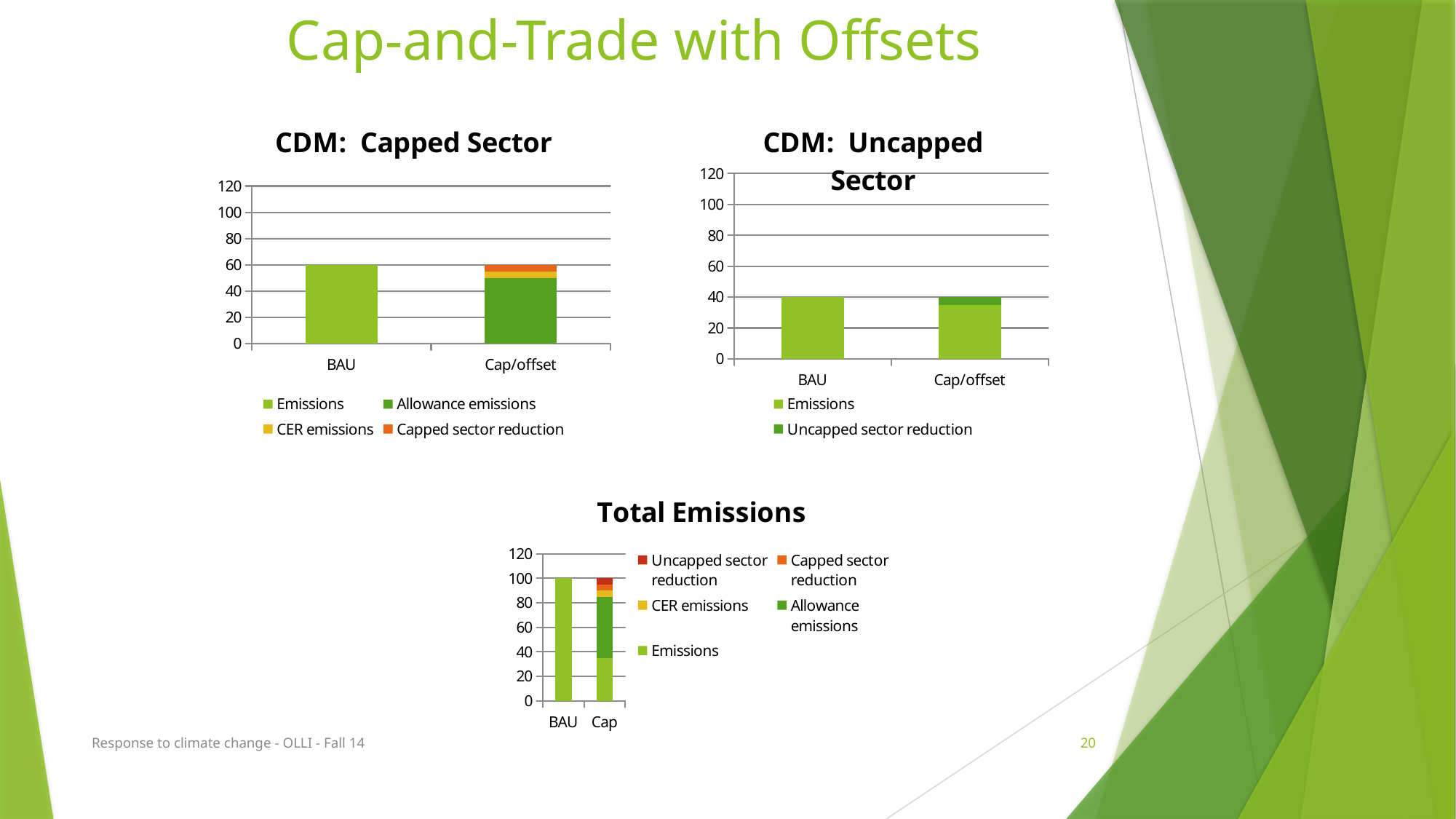
In the Total Emissions chart, is the Emissions value for Cap greater or less than 40? less In the CDM: Uncapped Sector chart, is the Emissions value for Cap/offset greater or less than 40? less In the Total Emissions chart, how many series does the legend list? 5 In the Total Emissions chart, what is the value of Emissions for BAU? 100 In the CDM: Capped Sector chart, how many categories are on the x axis? 2 In the CDM: Capped Sector chart, what colour represents Capped sector reduction in the legend? orange In the CDM: Uncapped Sector chart, how many series does the legend list? 2 In the CDM: Uncapped Sector chart, what is the value of Emissions for BAU? 40 In the CDM: Capped Sector chart, what kind of chart is shown? bar chart In the CDM: Capped Sector chart, how many series does the legend list? 4 In the CDM: Capped Sector chart, what is the value of Emissions for BAU? 60 In the CDM: Capped Sector chart, is the Allowance emissions value for Cap/offset greater or less than 40? greater